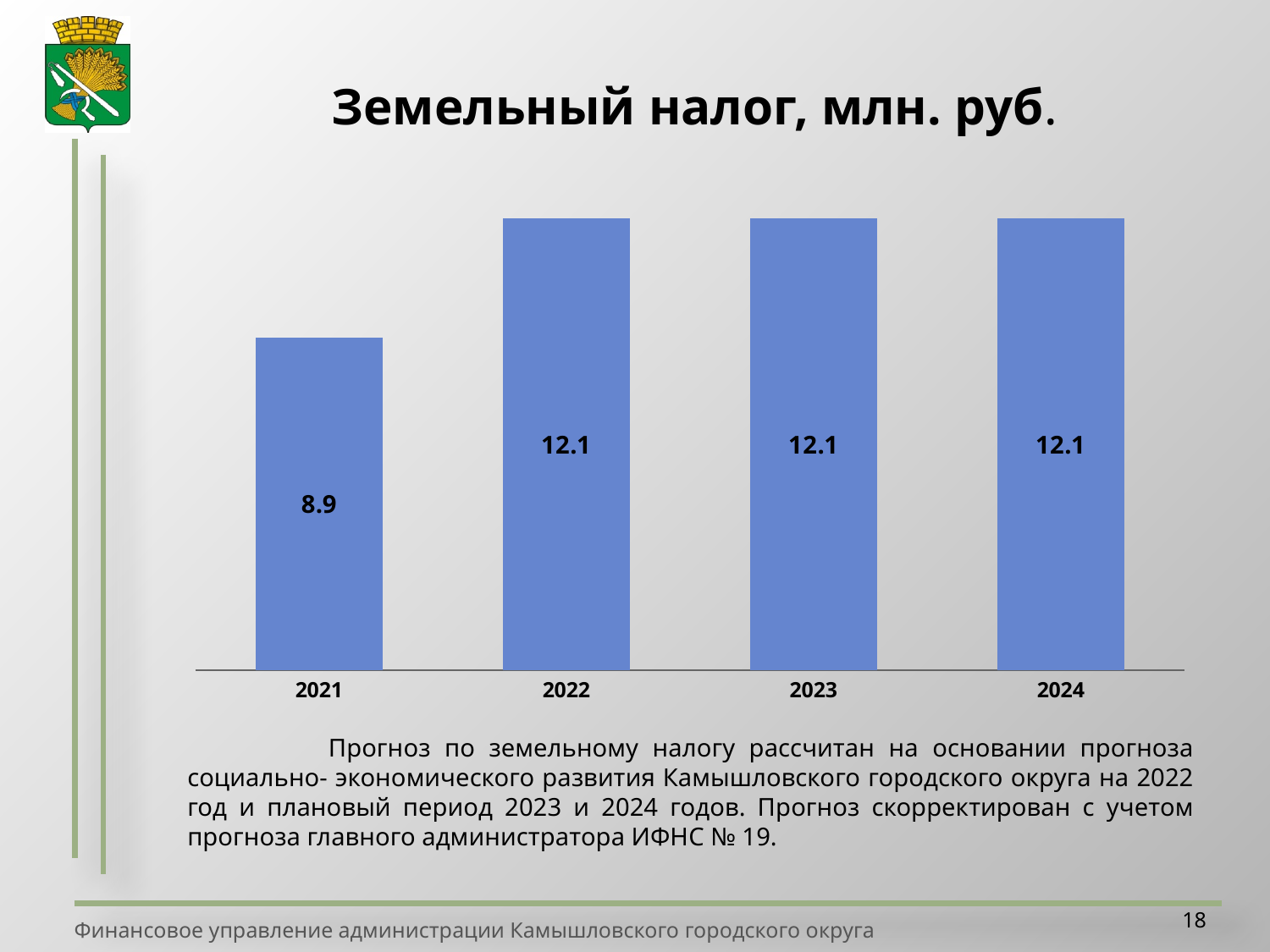
What is the title of the chart? Земельный налог, млн. руб. Does the value change between 2022 and 2024? no, it stays at 12.1 What is the difference between the values for 2022 and 2021? 3.2 Does the value rise or fall from 2021 to 2022? rise What is the value for 2022? 12.1 What colour are the bars in the chart? blue Which year has the lowest value? 2021 Which is larger, the value for 2021 or the value for 2023? 2023 What kind of chart is shown on the slide? bar chart How many years are shown on the chart? 4 What is the value for 2021? 8.9 What is the value for 2024? 12.1